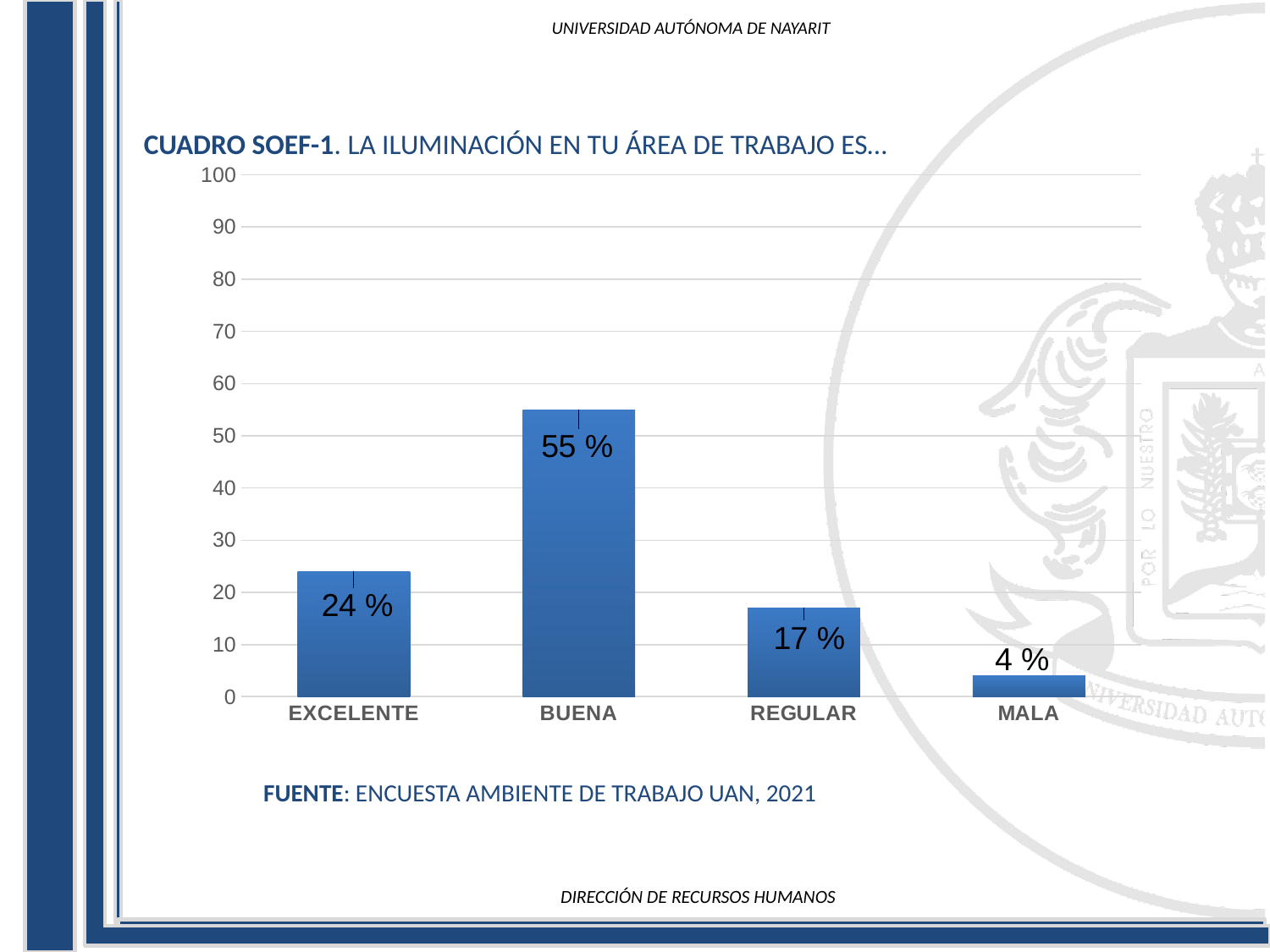
What kind of chart is shown on the slide? bar chart What is the difference between the values for BUENA and EXCELENTE? 31 % Is the value for BUENA greater or less than 50? greater What is the value for BUENA? 55 % What is the value for MALA? 4 % Which is larger, the value for EXCELENTE or the value for REGULAR? EXCELENTE How many categories are shown on the x axis? 4 Which category has the highest value? BUENA What is the value for EXCELENTE? 24 % What is the value for REGULAR? 17 % Which category has the lowest value? MALA What is the source cited below the chart? ENCUESTA AMBIENTE DE TRABAJO UAN, 2021